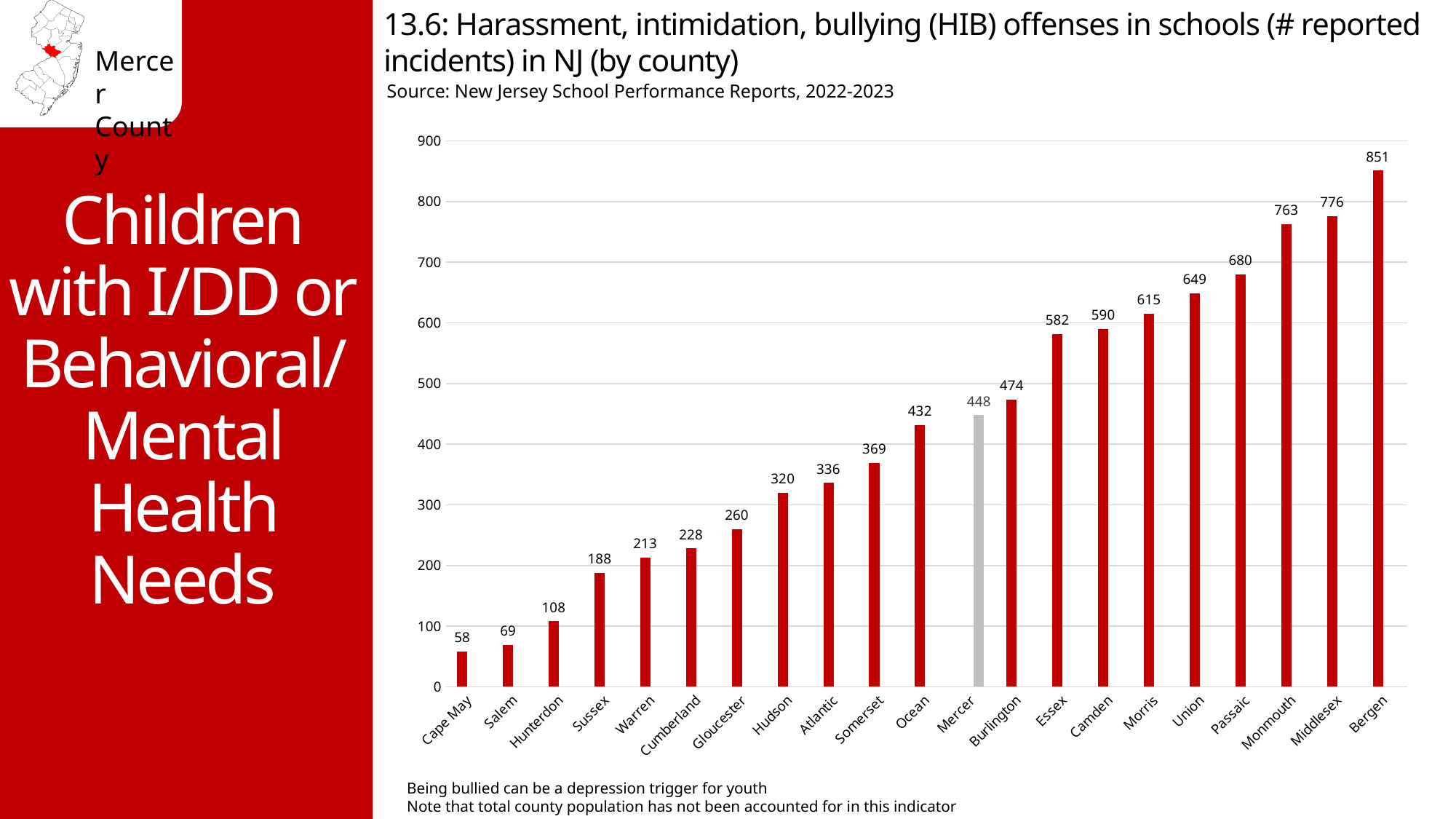
How many counties are shown on the chart? 21 What is the number of reported HIB incidents for Mercer County? 448 Which county has more reported HIB incidents, Essex or Camden? Camden Which county has the highest number of reported HIB incidents? Bergen Which county's bar is coloured grey instead of red? Mercer Do the values rise or fall from left to right along the x axis? Rise What kind of chart is shown on the slide? Bar chart What is the difference in reported HIB incidents between Bergen and Mercer? 403 What is the difference in reported HIB incidents between Middlesex and Monmouth? 13 What is the number of reported HIB incidents for Hudson County? 320 Is the value for Passaic greater or less than 700? less Which county has the lowest number of reported HIB incidents? Cape May